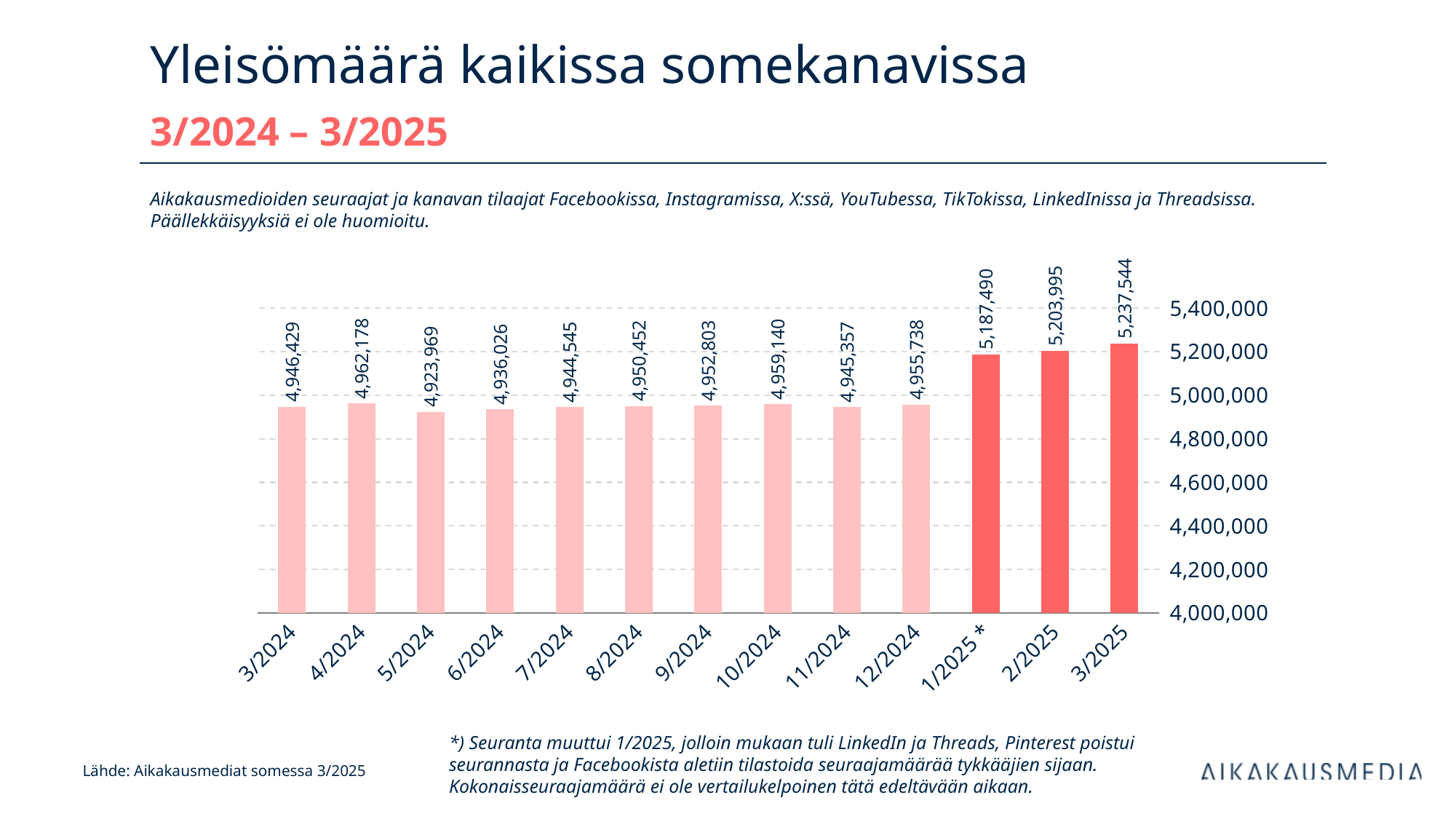
Do the values rise or fall from 1/2025 * to 3/2025? rise What is the difference between the values for 3/2025 and 1/2025 *? 50,054 What is the difference between the values for 2/2025 and 1/2025 *? 16,505 How many months are shown on the x axis? 13 Which month has the lowest value? 5/2024 Is the value for 2/2025 greater or less than 5,000,000? greater What is the value for 1/2025 *? 5,187,490 Which month has the highest value? 3/2025 What kind of chart is shown on the slide? bar chart What is the value for 5/2024? 4,923,969 Which is larger, the value for 4/2024 or the value for 5/2024? 4/2024 What is the value for 3/2025? 5,237,544